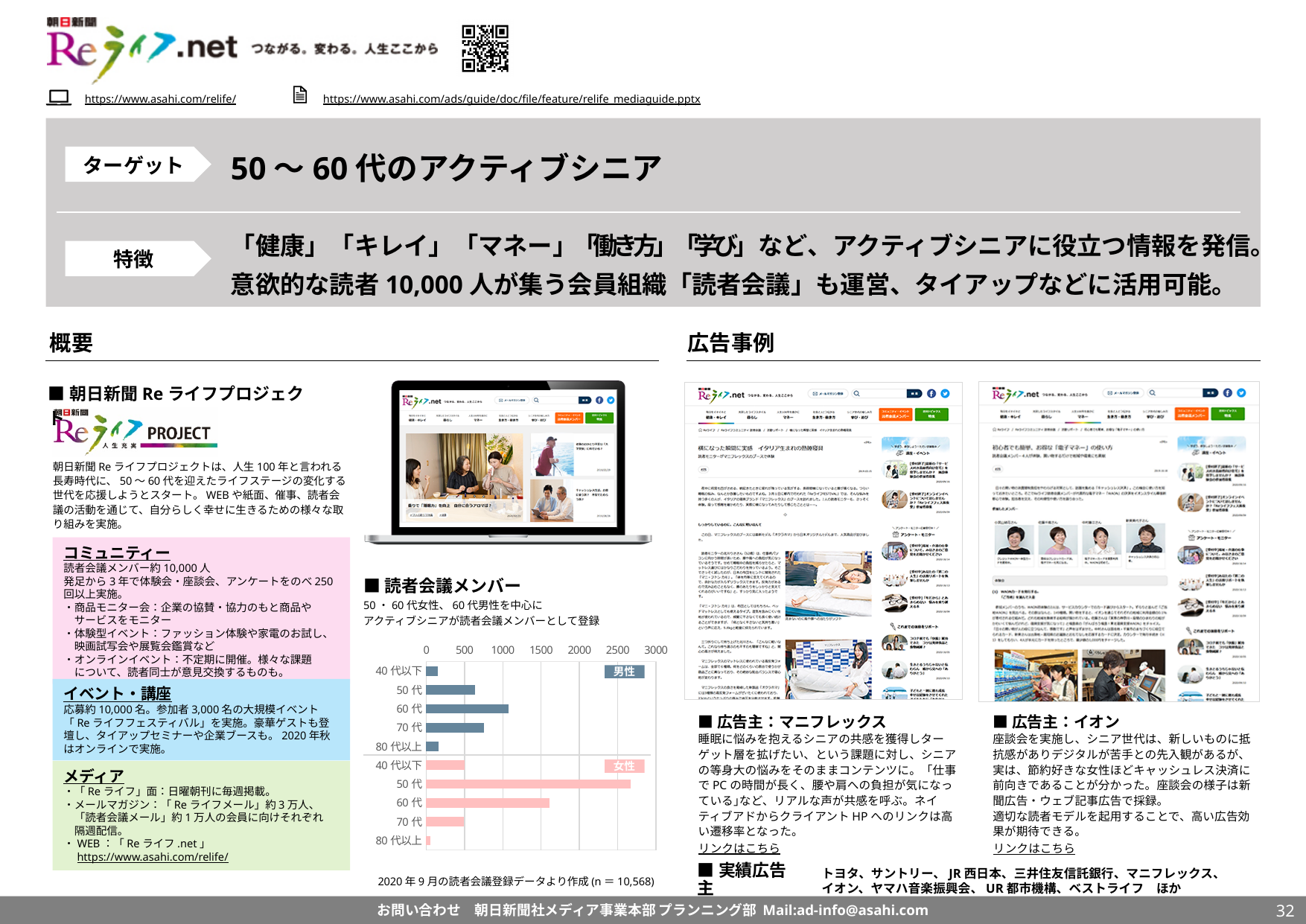
In the 読者会議メンバー chart, is the value for 男性 50代 greater or less than 1000? less According to the note under the 読者会議メンバー chart, what is the sample size (n) of the data? 10,568 What kind of chart is the 読者会議メンバー chart? bar chart In the 読者会議メンバー chart, which is larger: 女性 60代 or 男性 60代? 女性 60代 How many series does the 読者会議メンバー chart show? 2 In the 読者会議メンバー chart, which age category has the lowest value for 女性? 80代以上 In the 読者会議メンバー chart, is the value for 女性 50代 greater or less than 2500? greater How many age categories are shown for each series in the 読者会議メンバー chart? 5 In the 読者会議メンバー chart, which age category has the highest value for 女性? 50代 What are the two series shown in the 読者会議メンバー chart? 男性 and 女性 In the 読者会議メンバー chart, which age category has the highest value for 男性? 60代